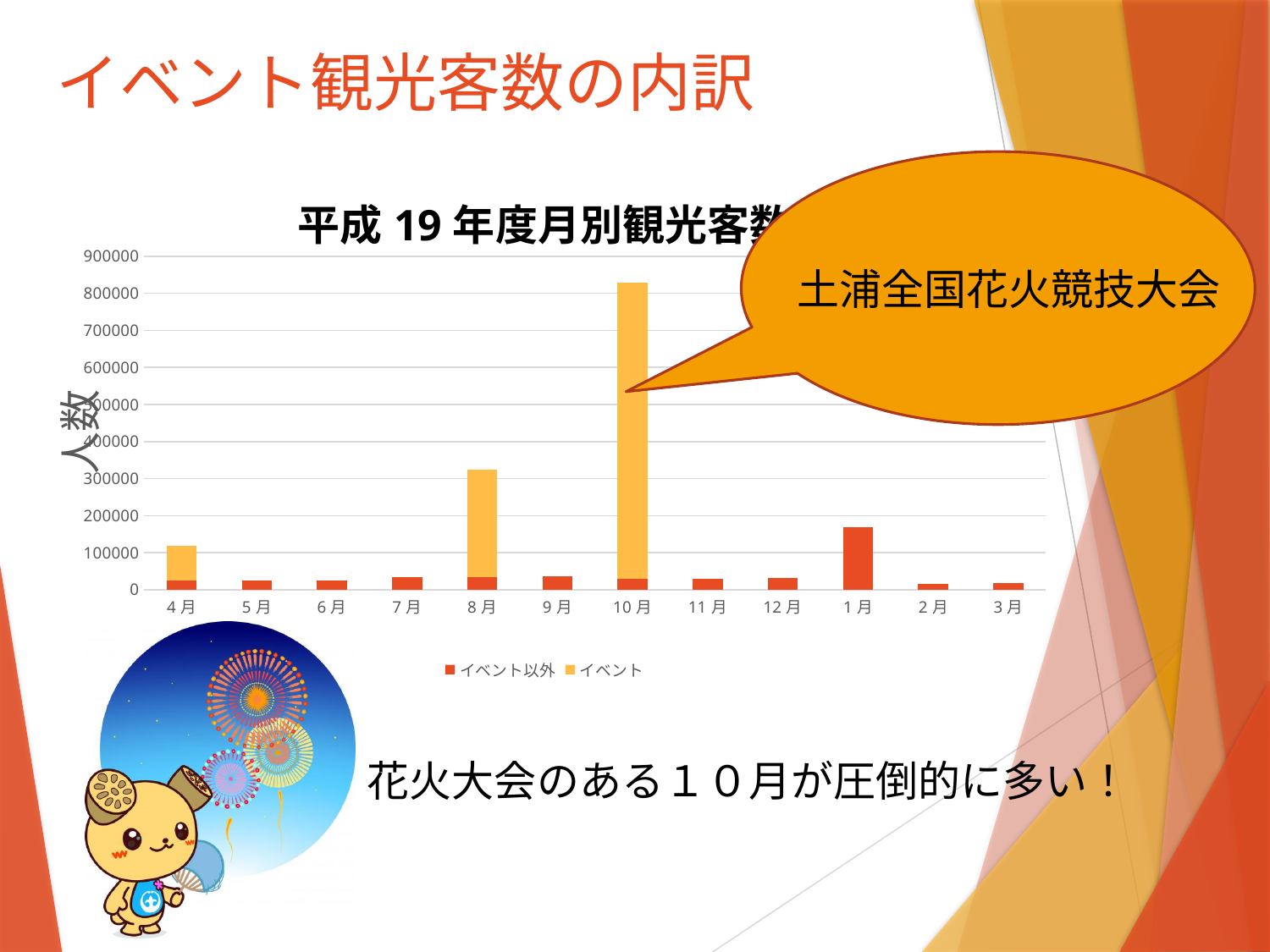
Is the total value for 4月 greater or less than 200000? less What kind of chart is shown on the slide? Stacked bar chart What are the two series names listed in the chart's legend? イベント以外, イベント How many series does the chart's legend list? 2 Which month has the larger total, 8月 or 1月? 8月 Is the total value for 1月 greater or less than 100000? greater Which series is shown in orange in the chart's legend? イベント How many months are shown on the x axis of the chart? 12 Which month has the highest total number of visitors in the chart? 10月 Is the total value for 2月 greater or less than 100000? less